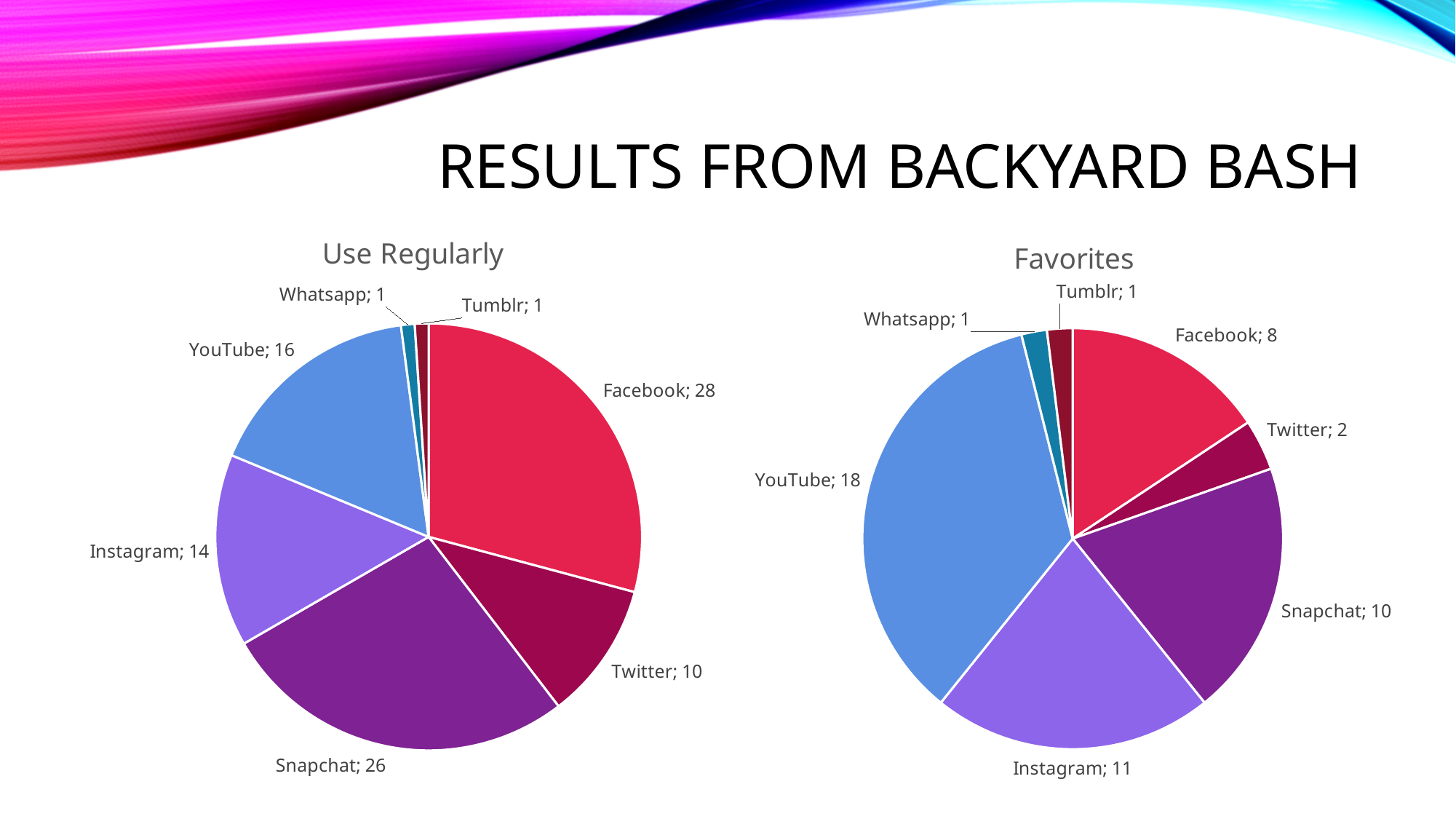
In the "Favorites" chart, which is larger, Facebook or Snapchat? Snapchat In the "Favorites" chart, what is the difference between the values for Instagram and Snapchat? 1 In the "Favorites" chart, which category has the largest slice? YouTube How many categories are shown in the "Favorites" chart? 7 What is the title of the chart on the right side of the slide? Favorites In the "Use Regularly" chart, which is larger, YouTube or Instagram? YouTube What type of chart is the "Use Regularly" chart? Pie chart In the "Use Regularly" chart, what is the value for Twitter? 10 In the "Favorites" chart, what is the value for YouTube? 18 In the "Use Regularly" chart, what is the difference between the values for Facebook and Snapchat? 2 In the "Use Regularly" chart, which category has the largest slice? Facebook In the "Use Regularly" chart, what is the value for Facebook? 28